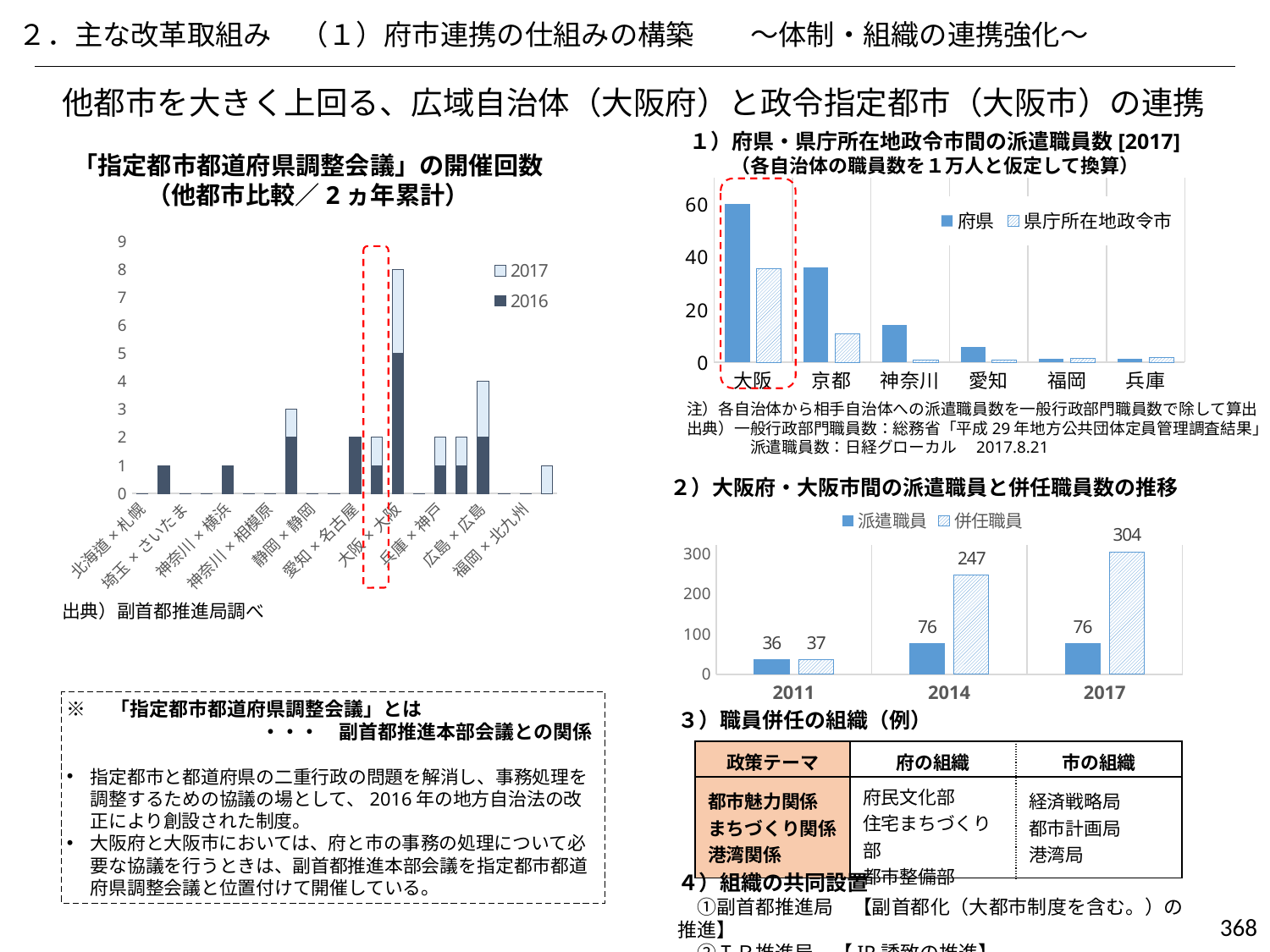
In the chart titled 大阪府・大阪市間の派遣職員と併任職員数の推移, which year has the highest value for 併任職員? 2017 In the chart titled 大阪府・大阪市間の派遣職員と併任職員数の推移, what is the value for 派遣職員 in 2014? 76 In the chart titled 大阪府・大阪市間の派遣職員と併任職員数の推移, what is the difference between 併任職員 in 2017 and 併任職員 in 2014? 57 In the chart titled 大阪府・大阪市間の派遣職員と併任職員数の推移, how many series does the legend list? 2 In the chart titled 大阪府・大阪市間の派遣職員と併任職員数の推移, what is the value for 併任職員 in 2011? 37 In the chart titled 府県・県庁所在地政令市間の派遣職員数 [2017], which is larger: the 府県 value for 神奈川 or the 府県 value for 愛知? 神奈川 In the chart titled 府県・県庁所在地政令市間の派遣職員数 [2017], is the value for 府県 in 京都 greater or less than 20? greater In the chart titled 府県・県庁所在地政令市間の派遣職員数 [2017], how many prefectures are shown on the x axis? 6 What kind of chart is the chart titled 「指定都市都道府県調整会議」の開催回数 on the left of the slide? stacked bar chart In the chart titled 大阪府・大阪市間の派遣職員と併任職員数の推移, what is the value for 併任職員 in 2017? 304 In the chart titled 府県・県庁所在地政令市間の派遣職員数 [2017], which prefecture has the highest value for 府県? 大阪 In the chart titled 大阪府・大阪市間の派遣職員と併任職員数の推移, does the value for 併任職員 rise or fall from 2011 to 2017? rise